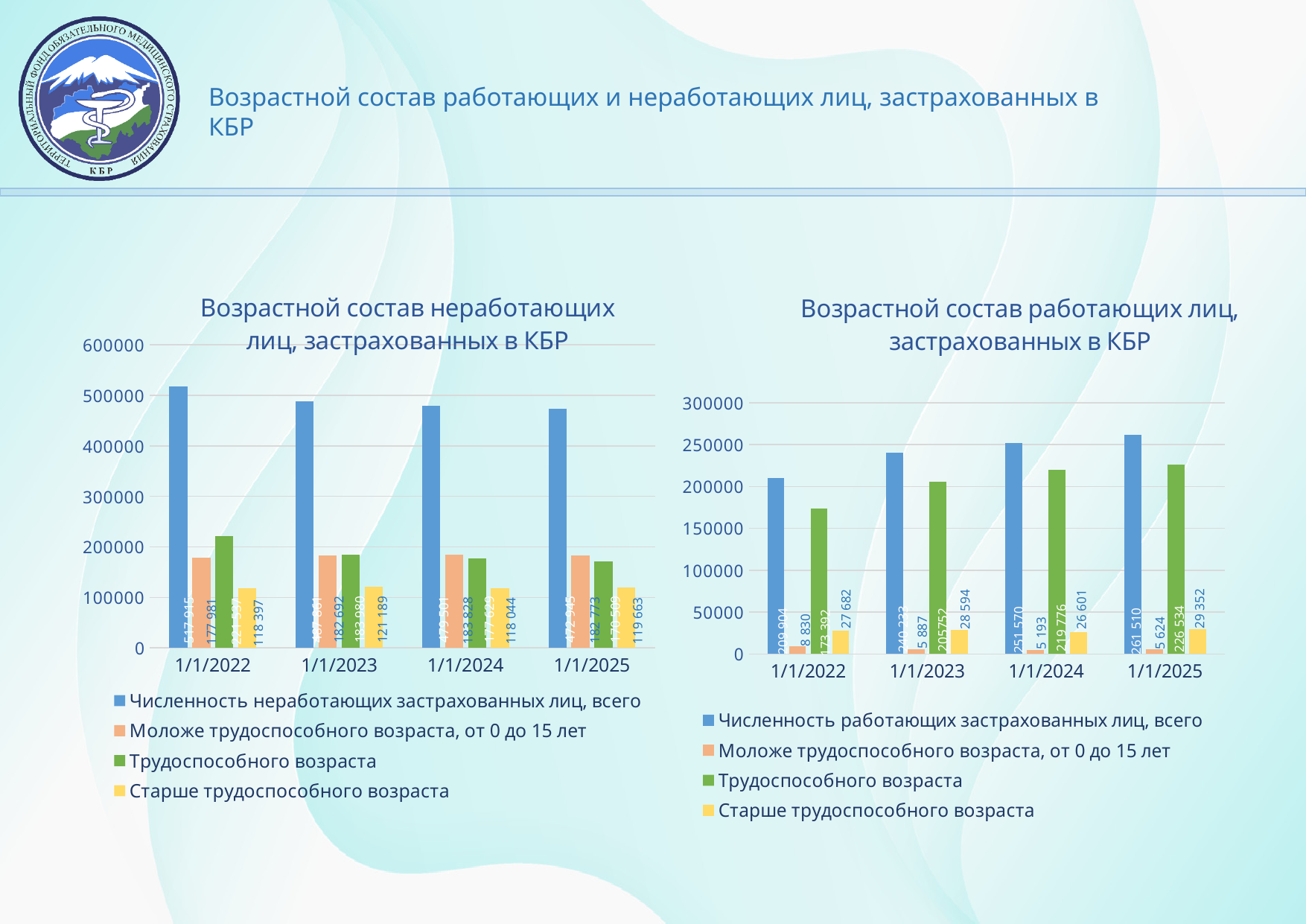
In the chart 'Возрастной состав работающих лиц, застрахованных в КБР', what is the value for 'Моложе трудоспособного возраста, от 0 до 15 лет' on 1/1/2022? 8 830 In the chart 'Возрастной состав неработающих лиц, застрахованных в КБР', on which date is the value for 'Старше трудоспособного возраста' highest? 1/1/2023 What kind of chart is 'Возрастной состав неработающих лиц, застрахованных в КБР'? bar chart In the chart 'Возрастной состав работающих лиц, застрахованных в КБР', do the values for 'Численность работающих застрахованных лиц, всего' rise or fall from 1/1/2022 to 1/1/2025? rise In the chart 'Возрастной состав работающих лиц, застрахованных в КБР', on which date is the value for 'Моложе трудоспособного возраста, от 0 до 15 лет' lowest? 1/1/2024 In the chart 'Возрастной состав неработающих лиц, застрахованных в КБР', what is the value for 'Моложе трудоспособного возраста, от 0 до 15 лет' on 1/1/2024? 183 828 In the chart 'Возрастной состав работающих лиц, застрахованных в КБР', what is the value for 'Трудоспособного возраста' on 1/1/2025? 226 534 In the chart 'Возрастной состав неработающих лиц, застрахованных в КБР', do the values for 'Численность неработающих застрахованных лиц, всего' rise or fall from 1/1/2022 to 1/1/2025? fall In the chart 'Возрастной состав неработающих лиц, застрахованных в КБР', what is the value for 'Старше трудоспособного возраста' on 1/1/2023? 121 189 How many series does the legend of the chart 'Возрастной состав работающих лиц, застрахованных в КБР' list? 4 In the chart 'Возрастной состав неработающих лиц, застрахованных в КБР', is the value for 'Численность неработающих застрахованных лиц, всего' on 1/1/2022 greater or less than 500000? greater In the chart 'Возрастной состав работающих лиц, застрахованных в КБР', what is the difference between the 'Старше трудоспособного возраста' values on 1/1/2025 and 1/1/2024? 2 751